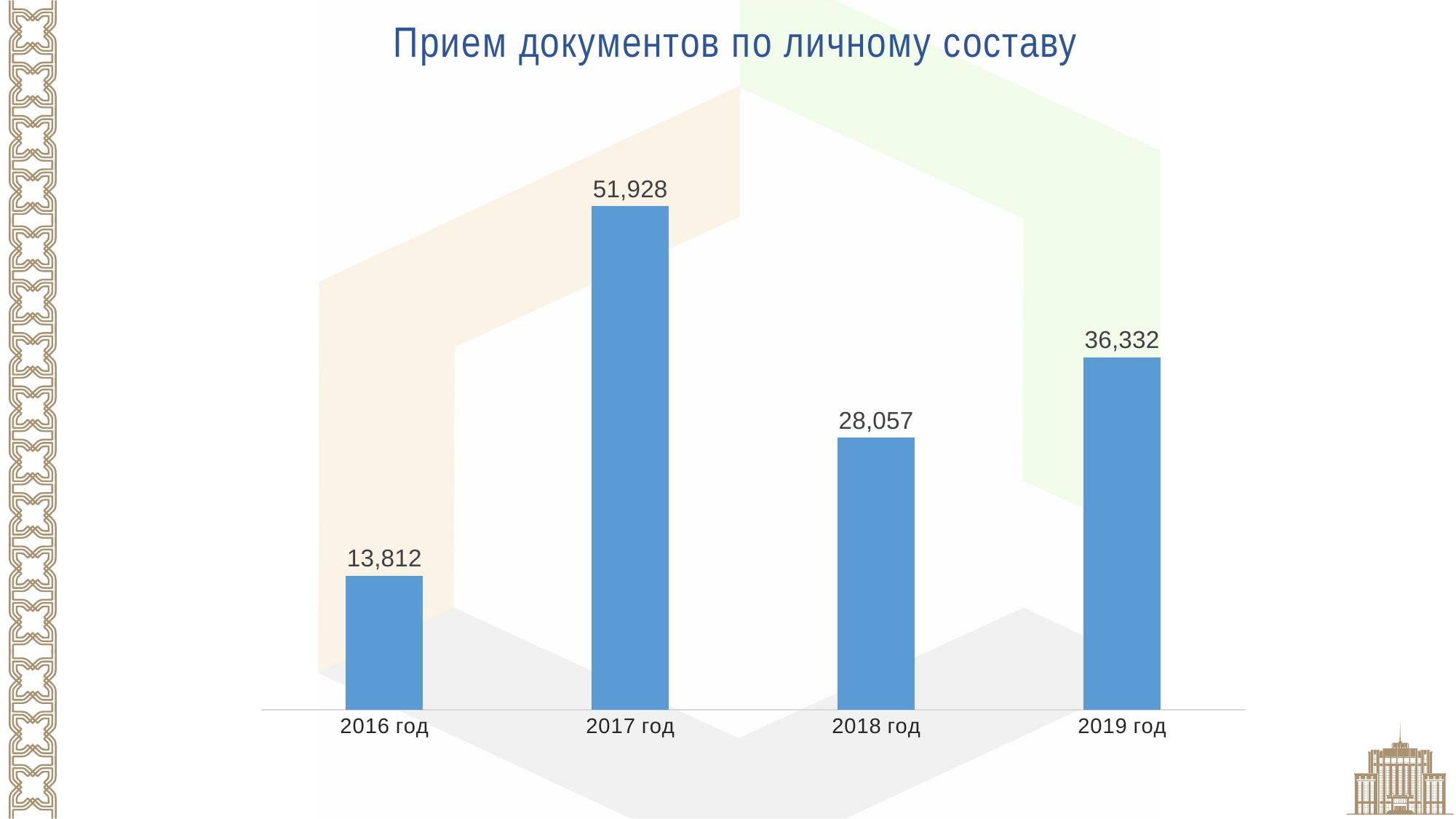
What is the value for 2019 год? 36,332 Which is larger, the value for 2018 год or the value for 2019 год? 2019 год What is the value for 2017 год? 51,928 Which year has the highest value? 2017 год What kind of chart is shown on the slide? bar chart What is the value for 2016 год? 13,812 What is the title of the chart? Прием документов по личному составу What is the difference between the values for 2019 год and 2018 год? 8,275 What is the difference between the values for 2017 год and 2016 год? 38,116 How many years are shown on the chart? 4 What is the value for 2018 год? 28,057 Which year has the lowest value? 2016 год